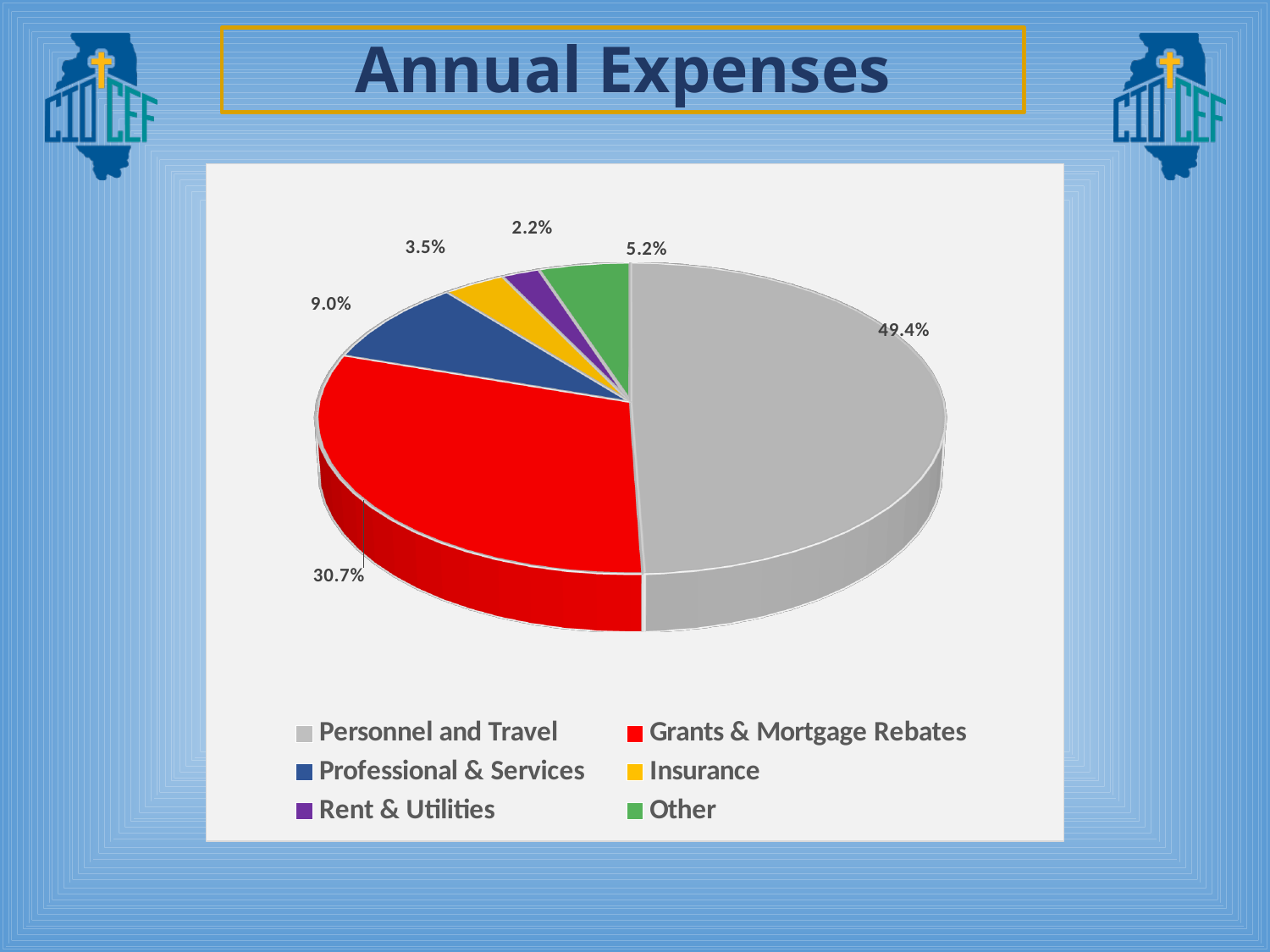
What kind of chart is shown on the slide? Pie chart Which expense category has the largest share? Personnel and Travel What share of annual expenses is Grants & Mortgage Rebates? 30.7% What is the difference in percentage points between Personnel and Travel and Grants & Mortgage Rebates? 18.7 What percentage is shown for Insurance? 3.5% What share of annual expenses is Personnel and Travel? 49.4% What percentage is shown for Professional & Services? 9.0% What is the title of the chart? Annual Expenses What percentage is shown for Other? 5.2% What percentage is shown for Rent & Utilities? 2.2% How many categories does the legend list? 6 Which expense category has the smallest share? Rent & Utilities